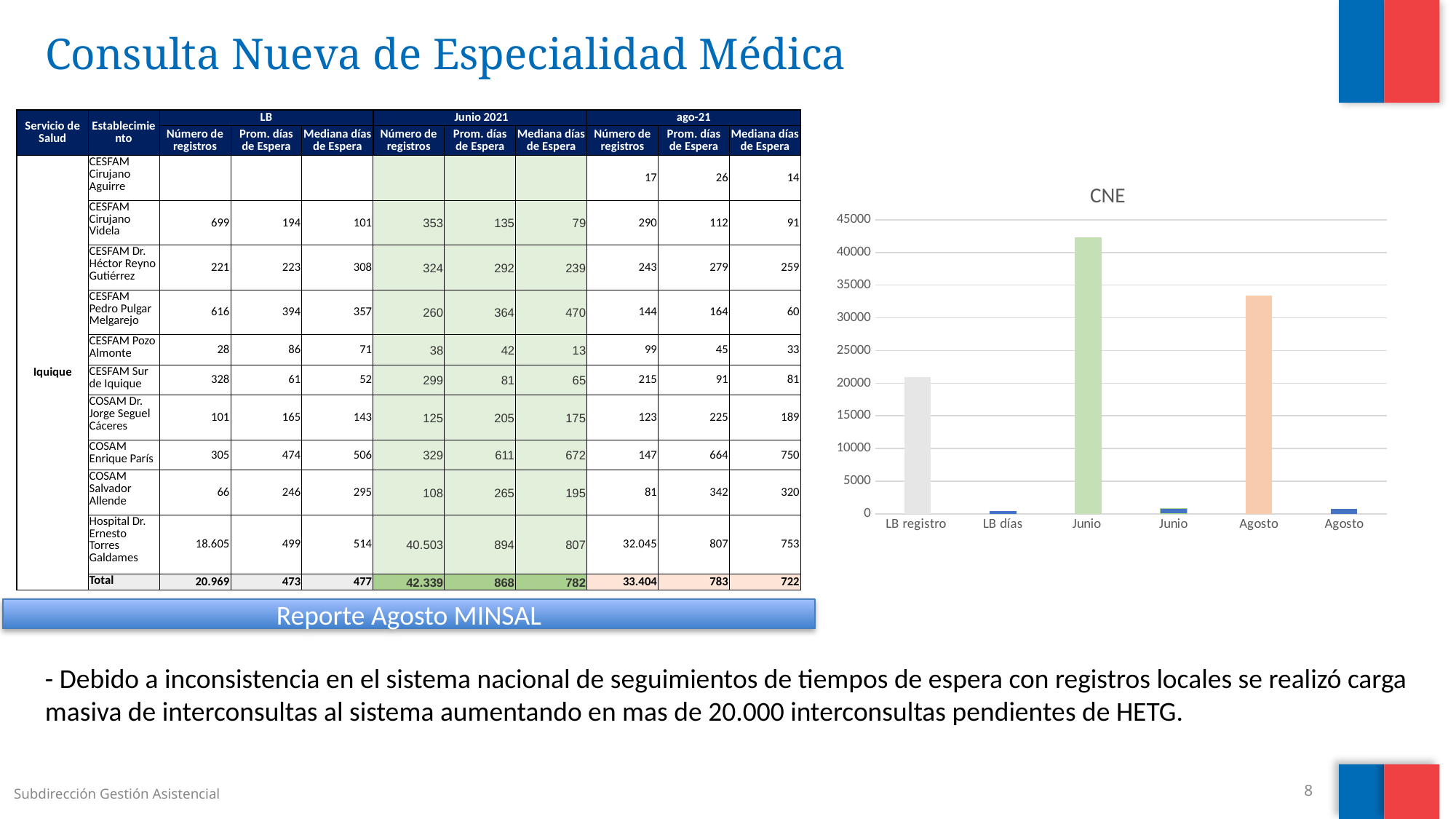
In the CNE chart, is the value for LB días greater or less than 5000? less In the CNE chart, what colour is the tallest bar? green What is the title of the chart on the right of the slide? CNE In the CNE chart, is the value for the first Agosto bar greater or less than 30000? greater In the CNE chart, is the value for the first Agosto bar greater or less than 35000? less In the CNE chart, which is larger: the tall Junio bar or the tall Agosto bar? Junio How many categories are shown on the x axis of the CNE chart? 6 In the CNE chart, which category has the tallest bar? Junio What kind of chart is the CNE chart on the slide? bar chart In the CNE chart, which is larger: the LB registro bar or the tall Agosto bar? Agosto